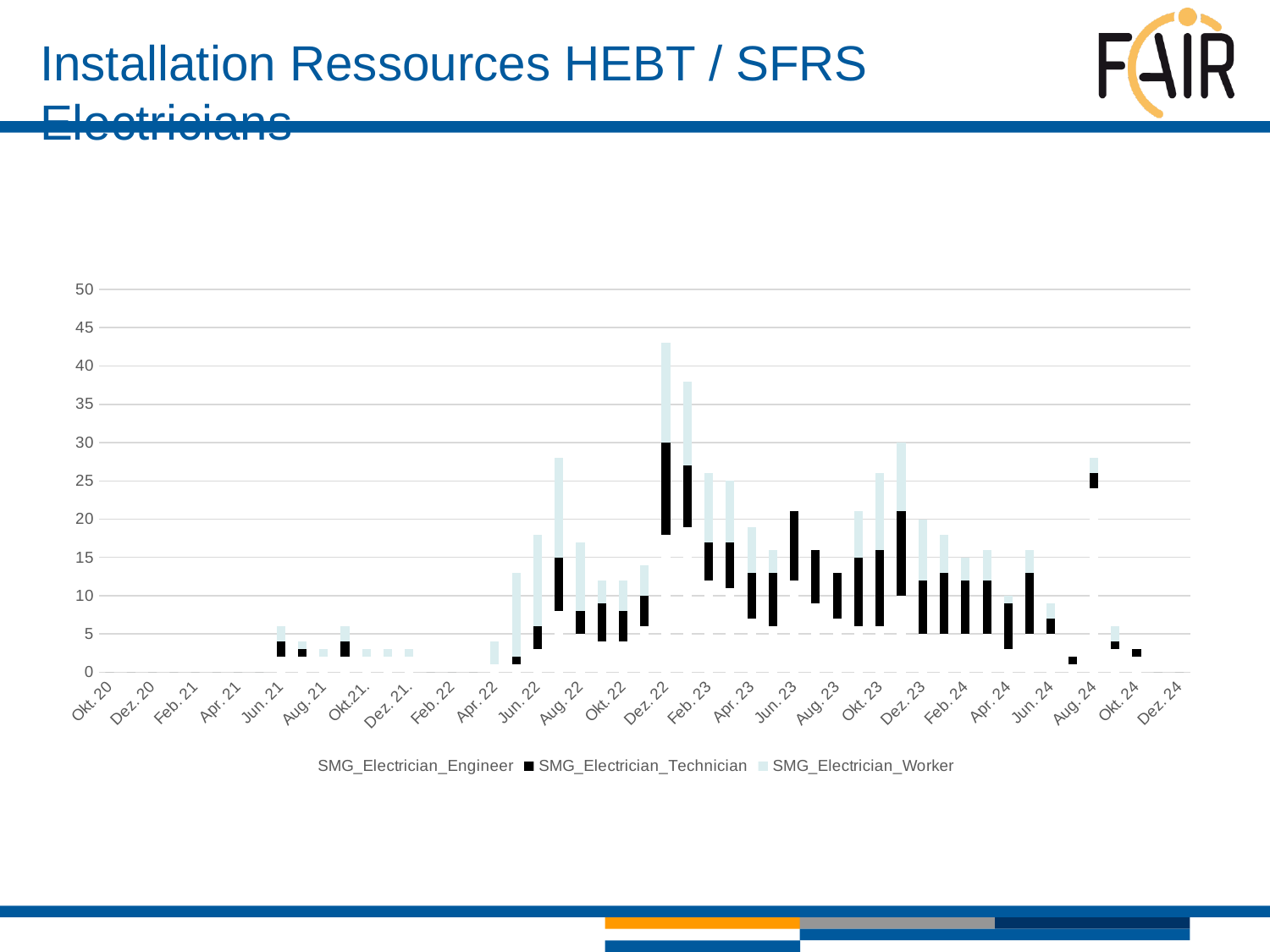
Is the total of the stacked bar at Aug. 22 greater or less than 25? less Which month label on the x axis is closest to the tallest stacked bar? Dez. 22 Which colour represents the SMG_Electrician_Technician series? black How many series does the legend list? 3 What is the first month label on the x axis? Okt. 20 Is the total of the stacked bar at Dez. 24 greater or less than 5? less What kind of chart is shown on the slide? stacked bar chart What are the three series named in the legend? SMG_Electrician_Engineer, SMG_Electrician_Technician, SMG_Electrician_Worker Which is larger, the total stacked bar at Dez. 22 or the total stacked bar at Jun. 21? Dez. 22 Is the total of the stacked bar at Jun. 21 greater or less than 10? less